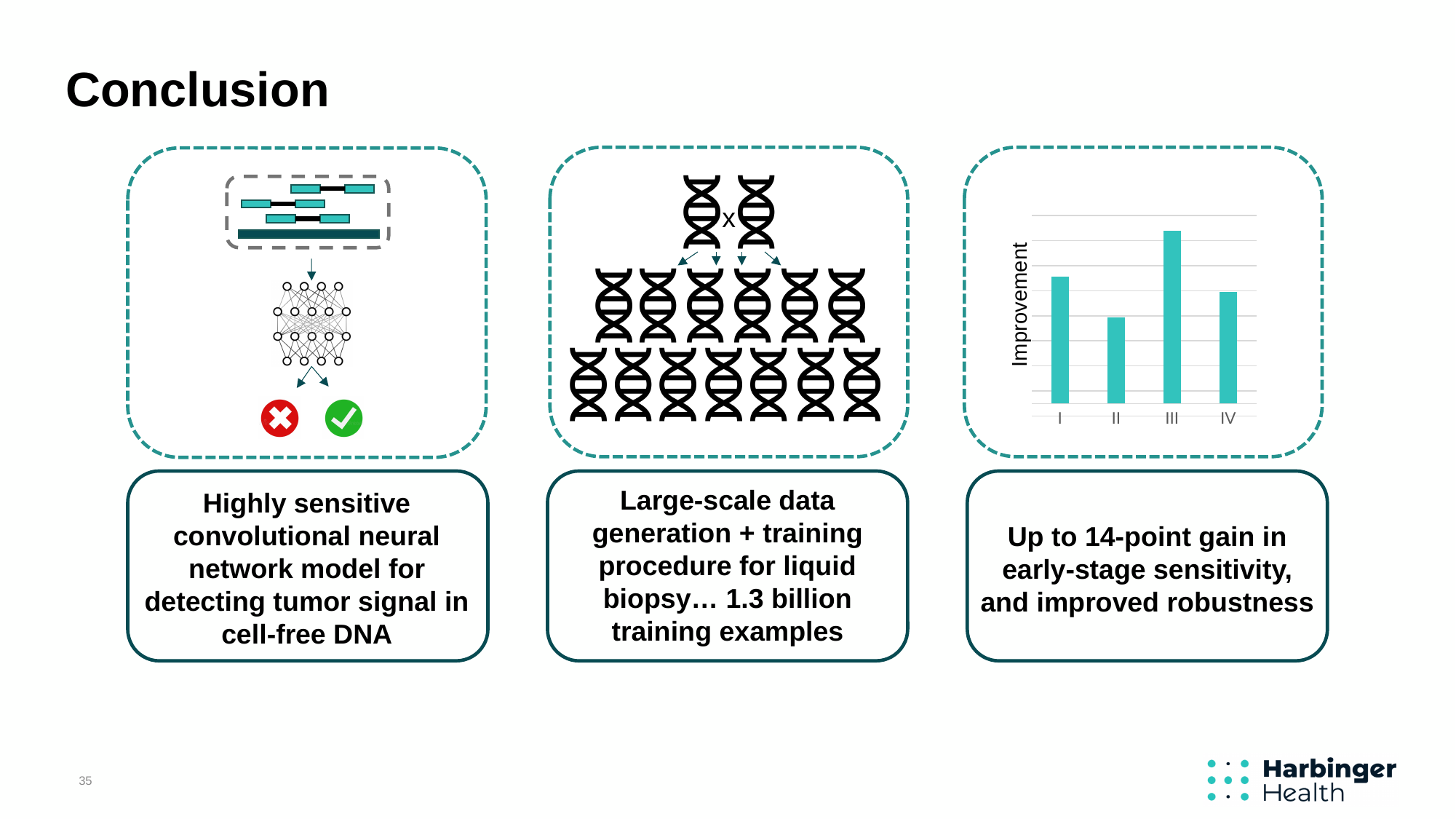
What kind of chart is shown in the right-hand panel of the slide? Bar chart Do the bars in the bar chart rise steadily from I to IV? No How many categories are shown on the x axis of the bar chart? 4 Which category has the shortest bar in the bar chart? II What are the category labels on the x axis of the bar chart? I, II, III, IV What is the label on the y axis of the bar chart? Improvement In the bar chart, which bar is taller, II or IV? IV In the bar chart, which bar is taller, I or II? I In the bar chart, is the bar for III taller or shorter than the bar for I? Taller Which category has the tallest bar in the bar chart? III